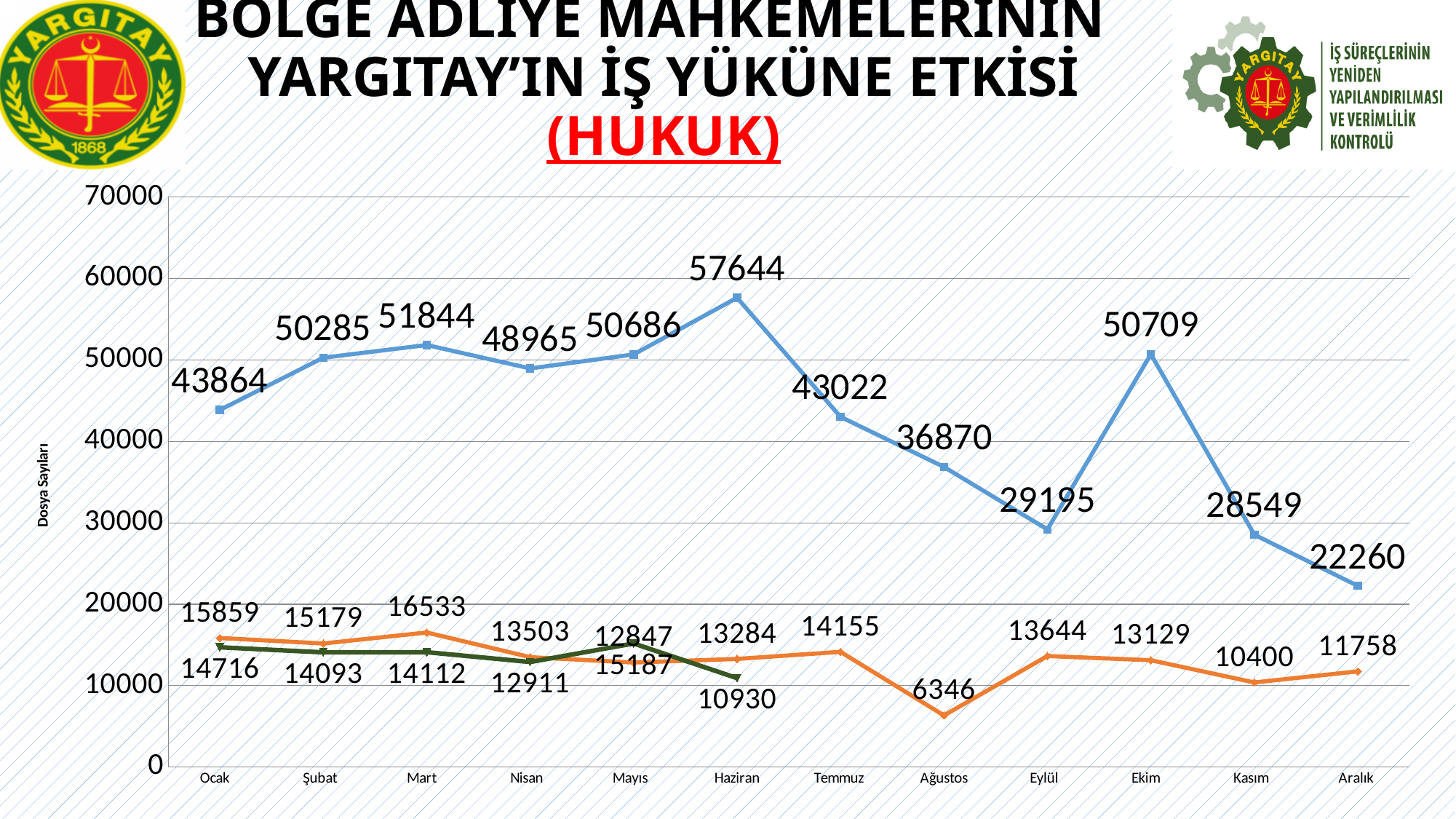
How many months are shown on the x axis of the chart? 12 In which month does the blue line reach its lowest value? Aralık What type of chart is shown on the slide? Line chart What is the label on the vertical axis of the chart? Dosya Sayıları Is the blue line's value for Eylül greater or less than 30000? less In which month does the blue line reach its highest value? Haziran In which month does the orange line reach its lowest value? Ağustos What is the value of the blue line for Aralık? 22260 What is the value of the orange line for Ağustos? 6346 Which is larger for Ocak: the orange line value or the dark green line value? Orange (15859) What is the value of the blue line for Haziran? 57644 What is the difference between the blue line's values for Ekim and Kasım? 22160